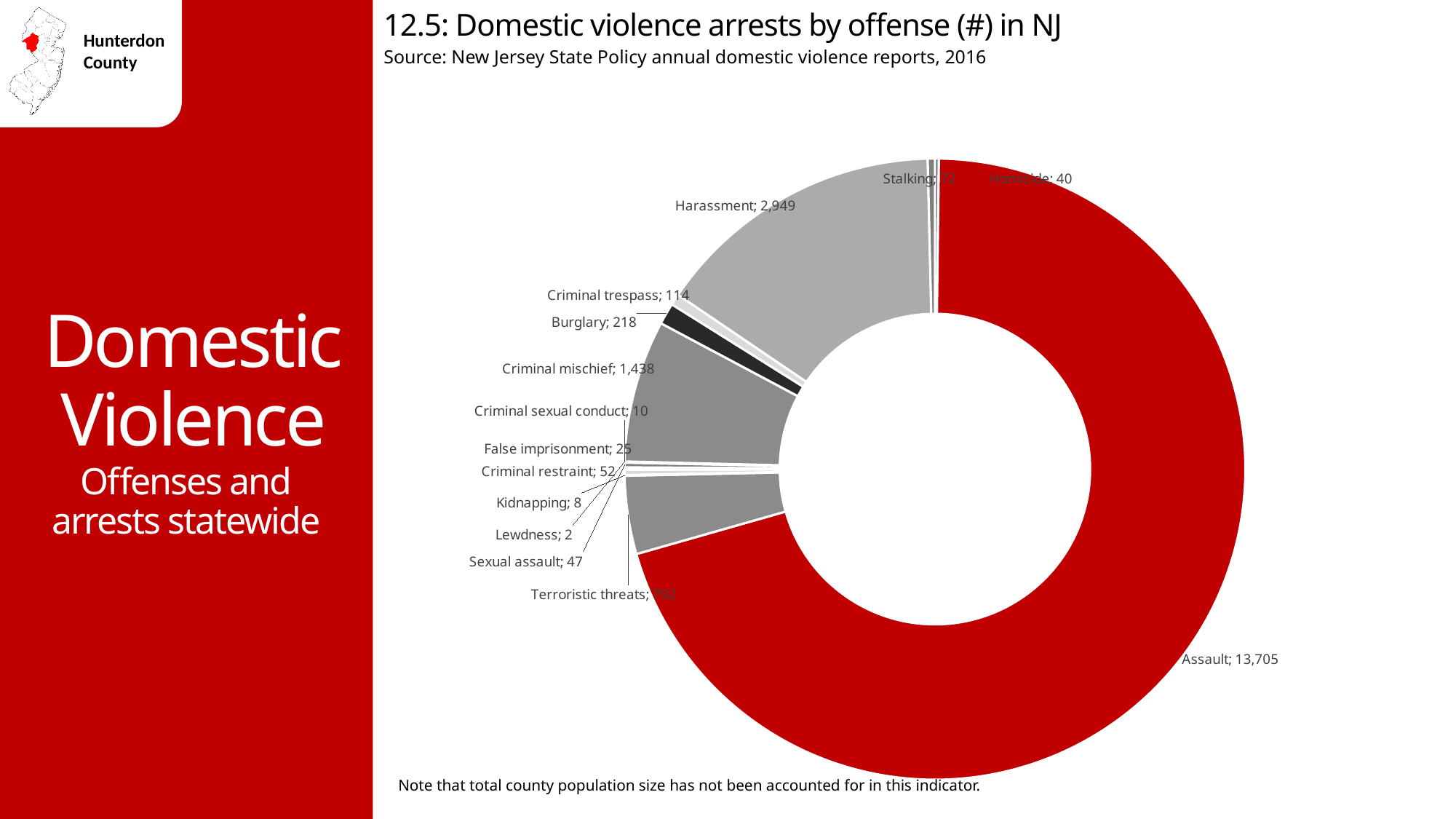
What is the number of domestic violence arrests for Assault? 13,705 What is the difference between the arrests for Harassment and Criminal mischief? 1,511 Which offense has the highest number of arrests? Assault Which has more arrests, Burglary or Criminal trespass? Burglary How many offense categories are shown in the chart? 14 What is the title of the chart? 12.5: Domestic violence arrests by offense (#) in NJ What is the number of arrests for Criminal mischief? 1,438 What is the number of arrests for Homicide? 40 What kind of chart is shown on the slide? Doughnut (pie) chart What is the number of arrests for Burglary? 218 What is the number of arrests for Harassment? 2,949 Which offense has the lowest number of arrests? Lewdness